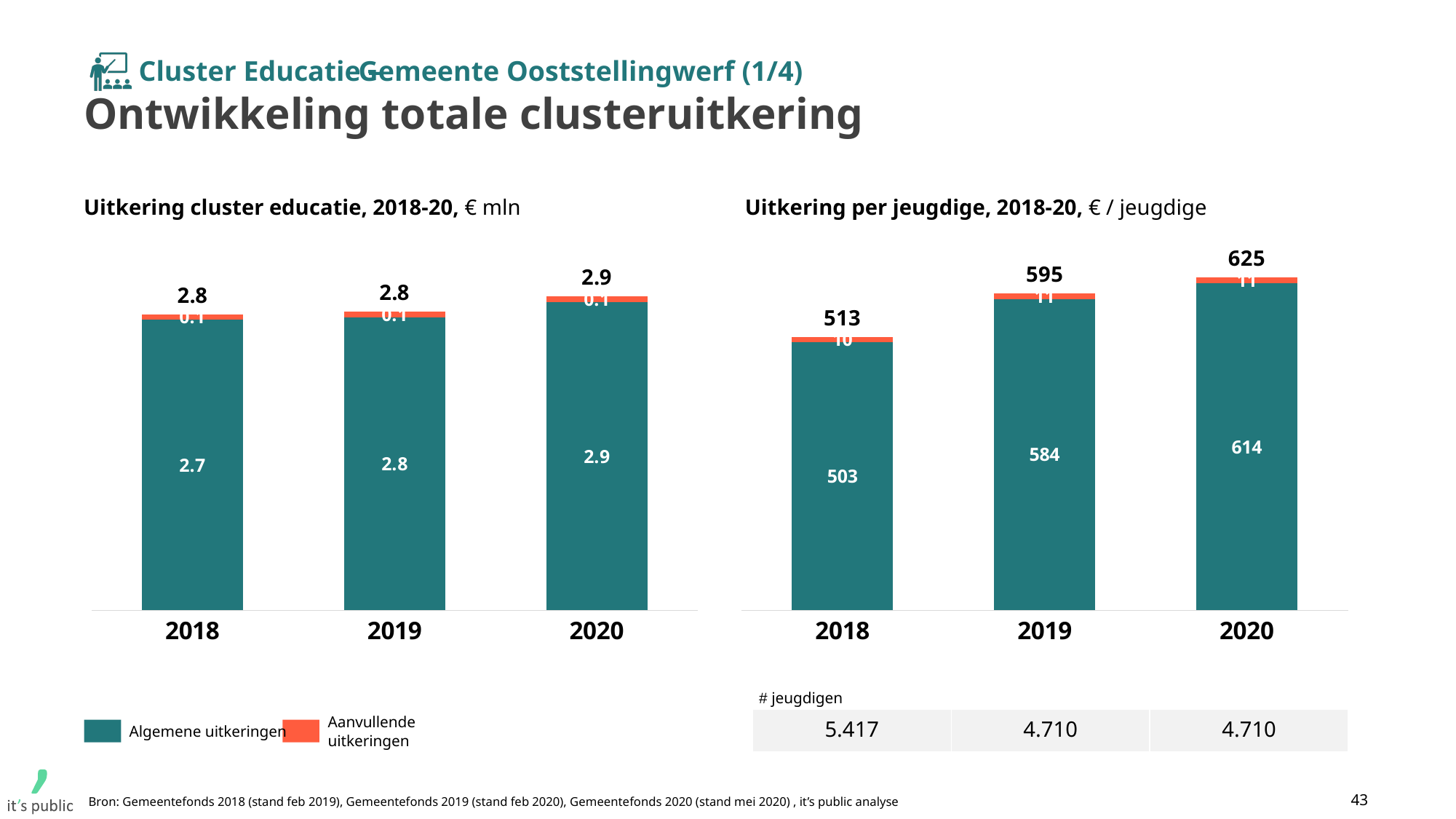
In the chart 'Uitkering per jeugdige, 2018-20', which year has the highest total? 2020 In the chart 'Uitkering cluster educatie, 2018-20', what is the value of Algemene uitkeringen for 2019? 2.8 In the chart 'Uitkering per jeugdige, 2018-20', which year has the lowest total? 2018 In the chart 'Uitkering per jeugdige, 2018-20', what is the difference between the total for 2020 and the total for 2018? 112 How many years are shown on the x axis of the chart 'Uitkering cluster educatie, 2018-20'? 3 In the chart 'Uitkering per jeugdige, 2018-20', what is the difference between Algemene uitkeringen in 2020 and in 2018? 111 What kind of chart is 'Uitkering per jeugdige, 2018-20'? Stacked bar chart In the chart 'Uitkering per jeugdige, 2018-20', is the total for 2019 larger or smaller than the total for 2018? larger How many series does the legend list for the charts on this slide? 2 In the chart 'Uitkering per jeugdige, 2018-20', what is the value of Algemene uitkeringen for 2018? 503 In the chart 'Uitkering cluster educatie, 2018-20', what is the total value for 2020? 2.9 In the chart 'Uitkering per jeugdige, 2018-20', what is the total value for 2020? 625